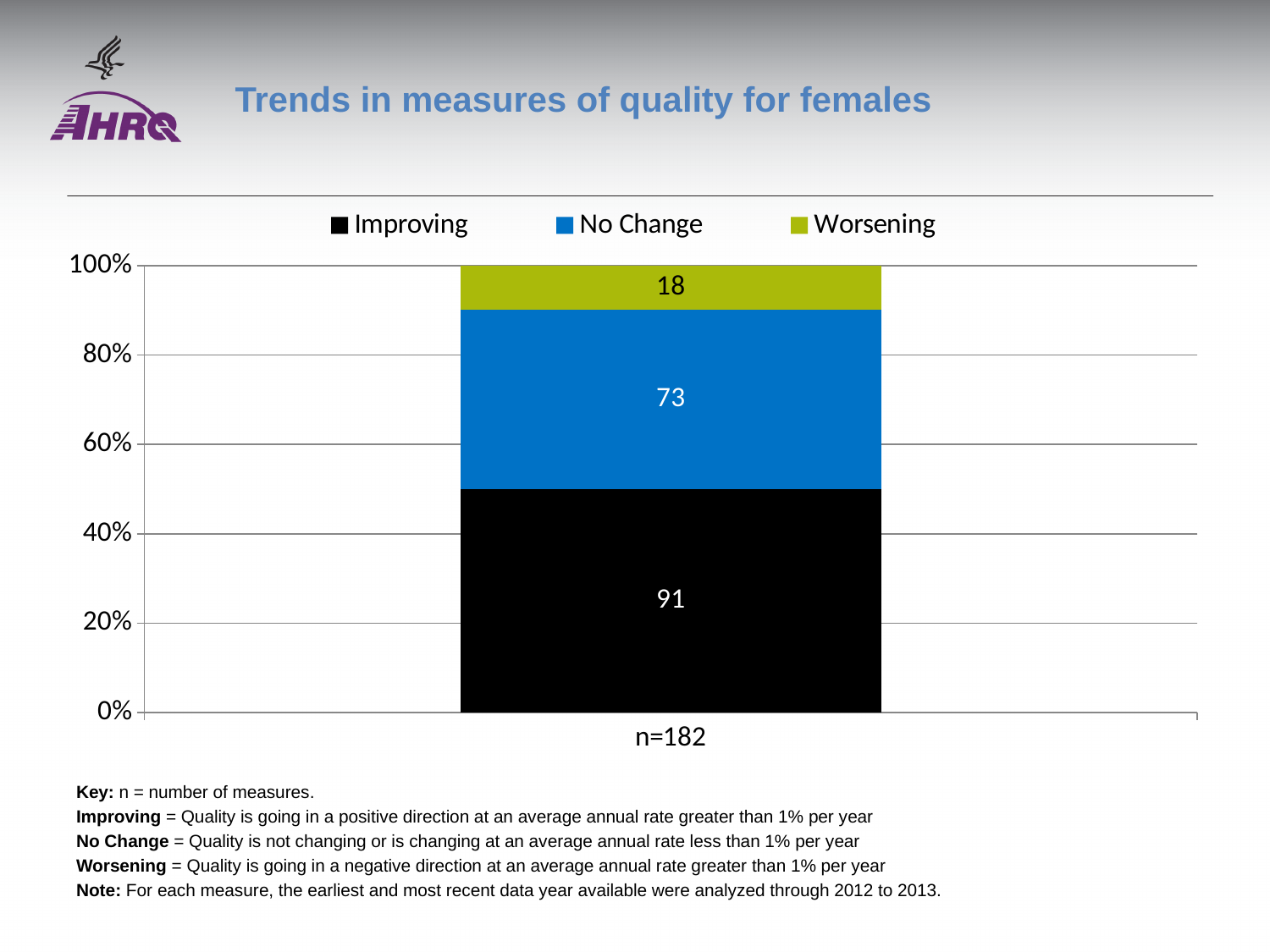
What is the total of the stacked bar labelled n=182? 182 What is the title of the chart? Trends in measures of quality for females How many series does the legend list? 3 What kind of chart is shown on the slide? Stacked bar chart Which series has the lowest value in the n=182 bar? Worsening What is the value for Worsening in the n=182 bar? 18 What is the difference between the No Change and Worsening values? 55 What is the value for No Change in the n=182 bar? 73 What is the difference between the Improving and No Change values? 18 What is the value for Improving in the n=182 bar? 91 Which series has the highest value in the n=182 bar? Improving Which is larger, the Improving value or the Worsening value? Improving